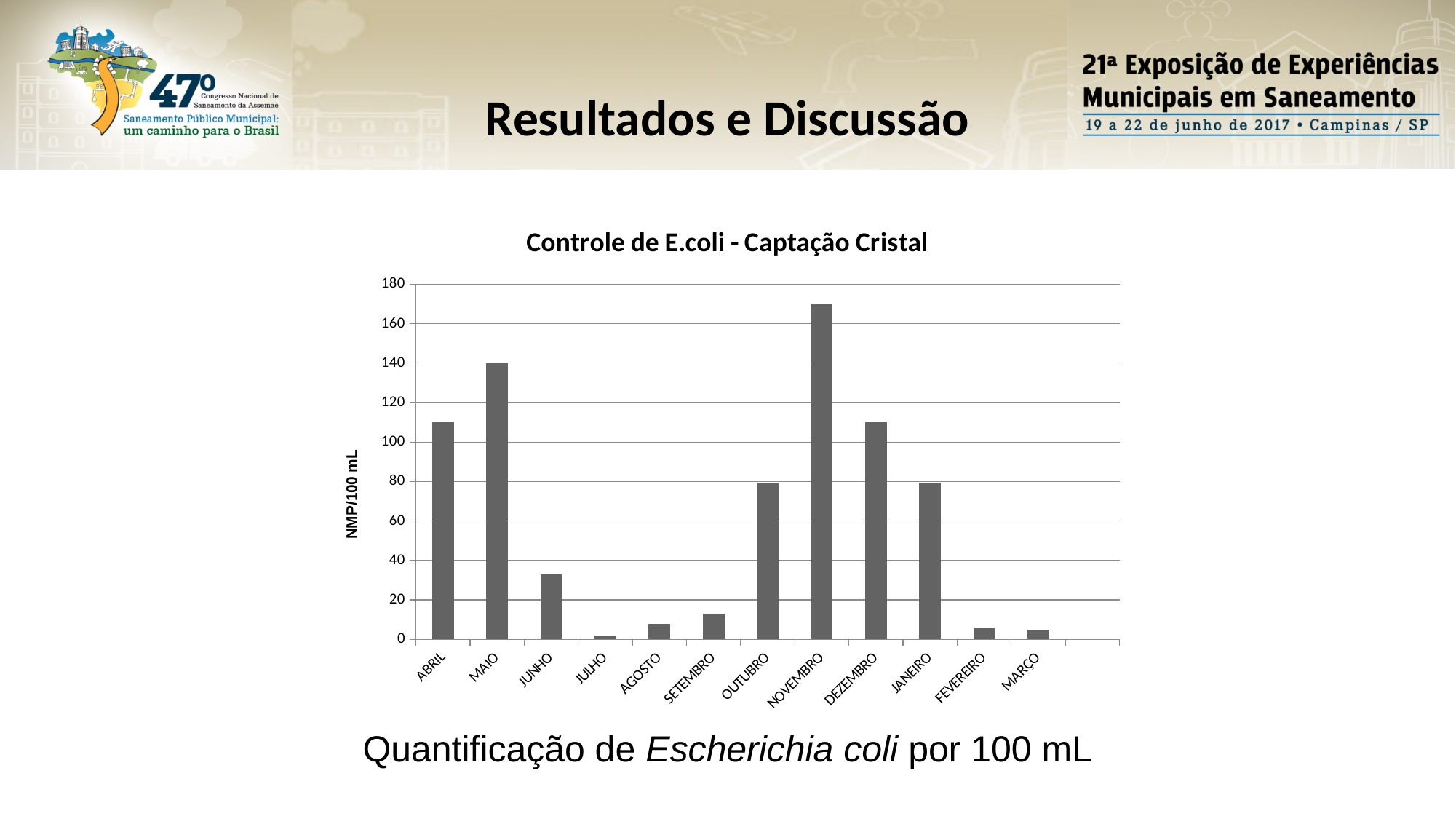
What is the title of the chart? Controle de E.coli - Captação Cristal Is the value for NOVEMBRO greater or less than 160? greater Which month has a larger value, MAIO or ABRIL? MAIO Which month has the lowest value in the chart? JULHO How many months are shown on the x axis of the chart? 12 Is the value for ABRIL greater or less than 100? greater What type of chart is shown on the slide? bar chart Is the value for JUNHO greater or less than 40? less What is the value for MAIO in the chart? 140 What is the label on the vertical axis of the chart? NMP/100 mL Which month has the highest value in the chart? NOVEMBRO